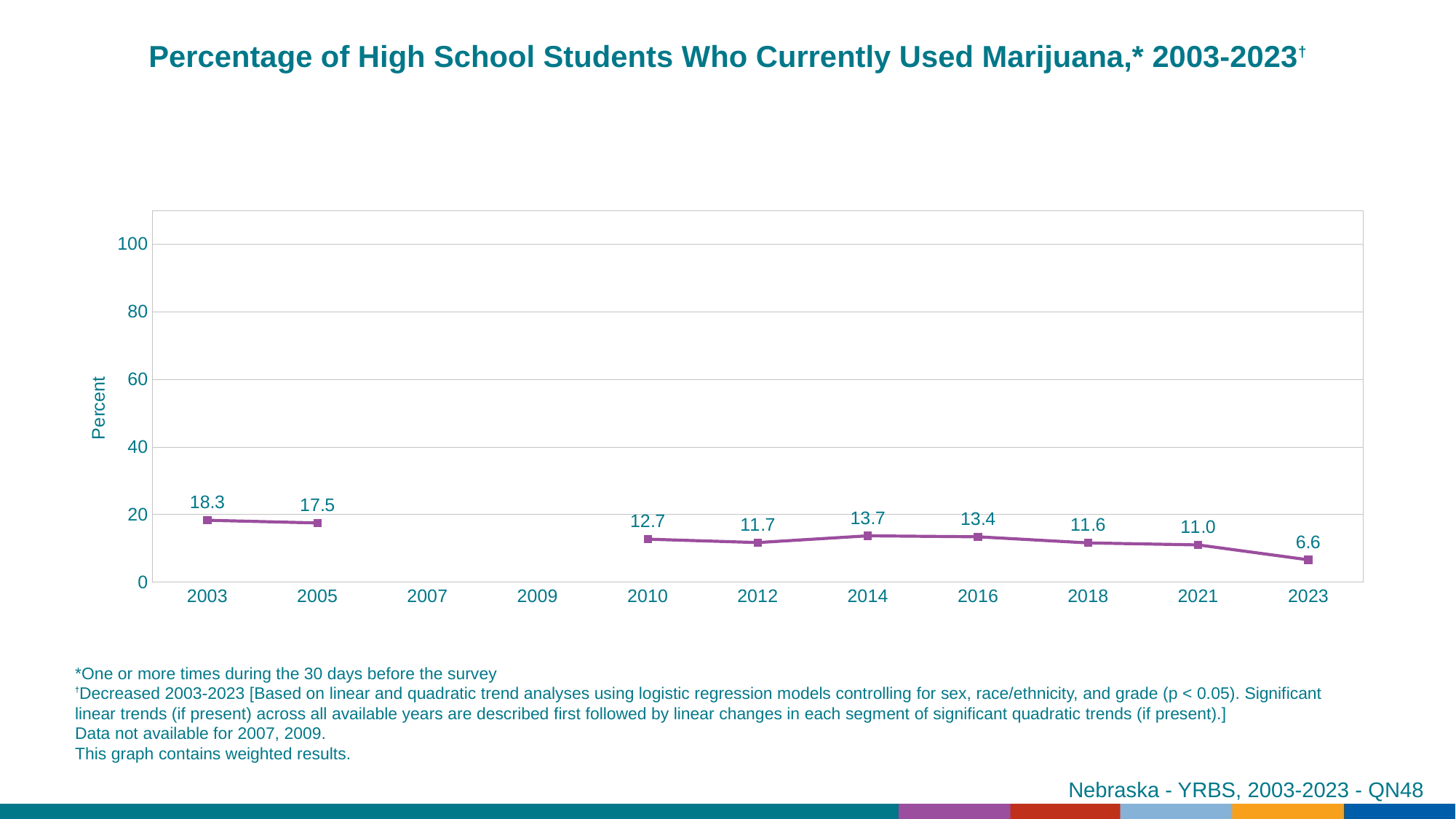
What is the label on the y axis? Percent What is the value for 2003? 18.3 What is the value for 2023? 6.6 Which is larger, the value for 2012 or the value for 2016? 2016 What kind of chart is this? line chart Do the values generally rise or fall from 2003 to 2023? fall Which year has the highest value? 2003 How many years have data points plotted on the chart? 9 What is the value for 2014? 13.7 Which year has the lowest value? 2023 What is the difference between the values for 2003 and 2023? 11.7 Is the value for 2005 greater or less than 20? less